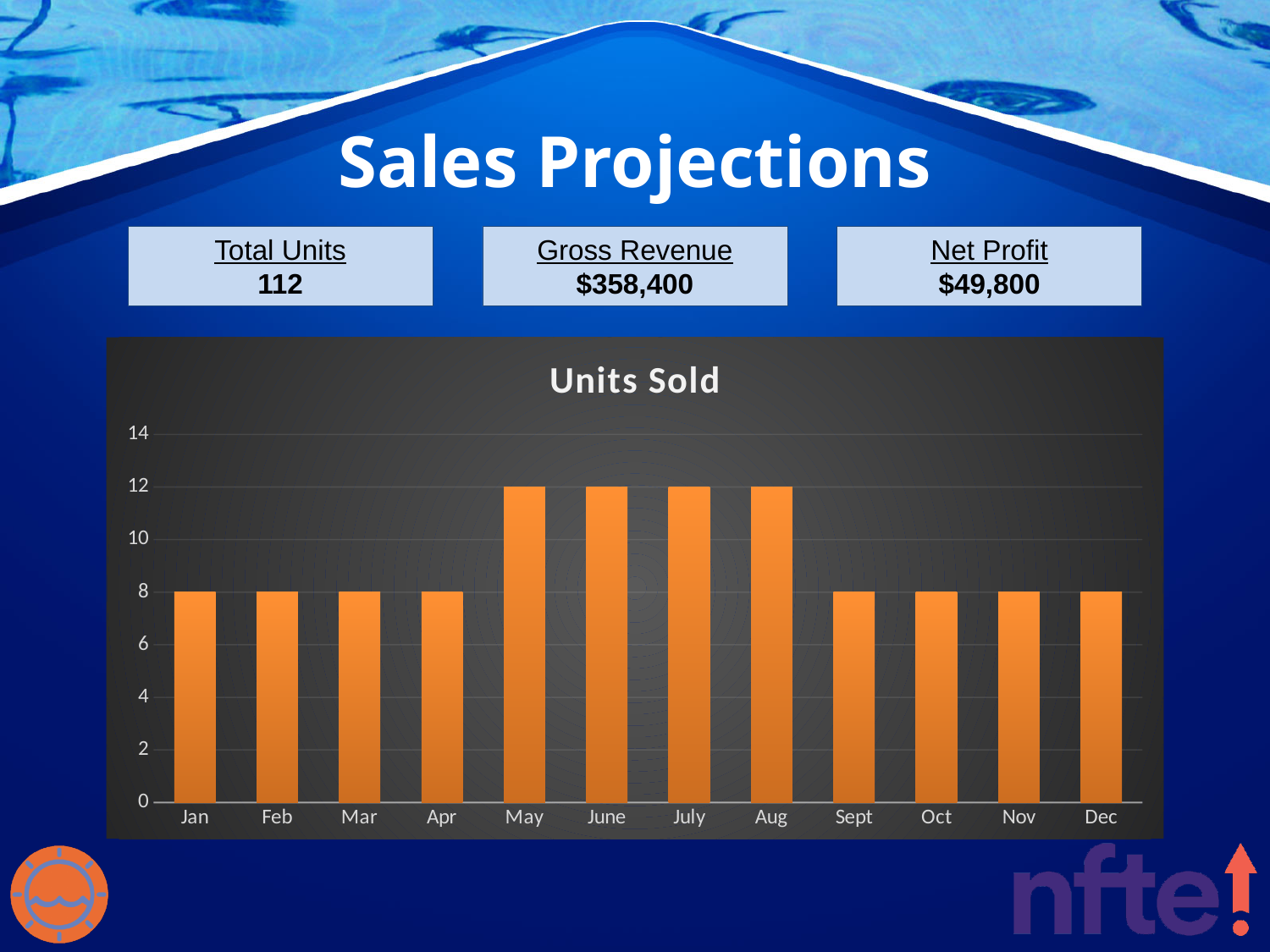
What is the value for Dec in the Units Sold chart? 8 How many months are shown on the x axis of the Units Sold chart? 12 What type of chart is shown on the slide? bar chart Is the value for Oct in the Units Sold chart greater or less than 10? less What is the value for June in the Units Sold chart? 12 What is the difference between the value for July and the value for Apr in the Units Sold chart? 4 What is the value for Jan in the Units Sold chart? 8 What is the highest value shown on the y axis of the Units Sold chart? 14 Is the value for Aug in the Units Sold chart greater or less than 10? greater Which is larger in the Units Sold chart, the value for May or the value for Sept? May Which months have the highest value in the Units Sold chart? May, June, July, Aug What is the title of the chart? Units Sold